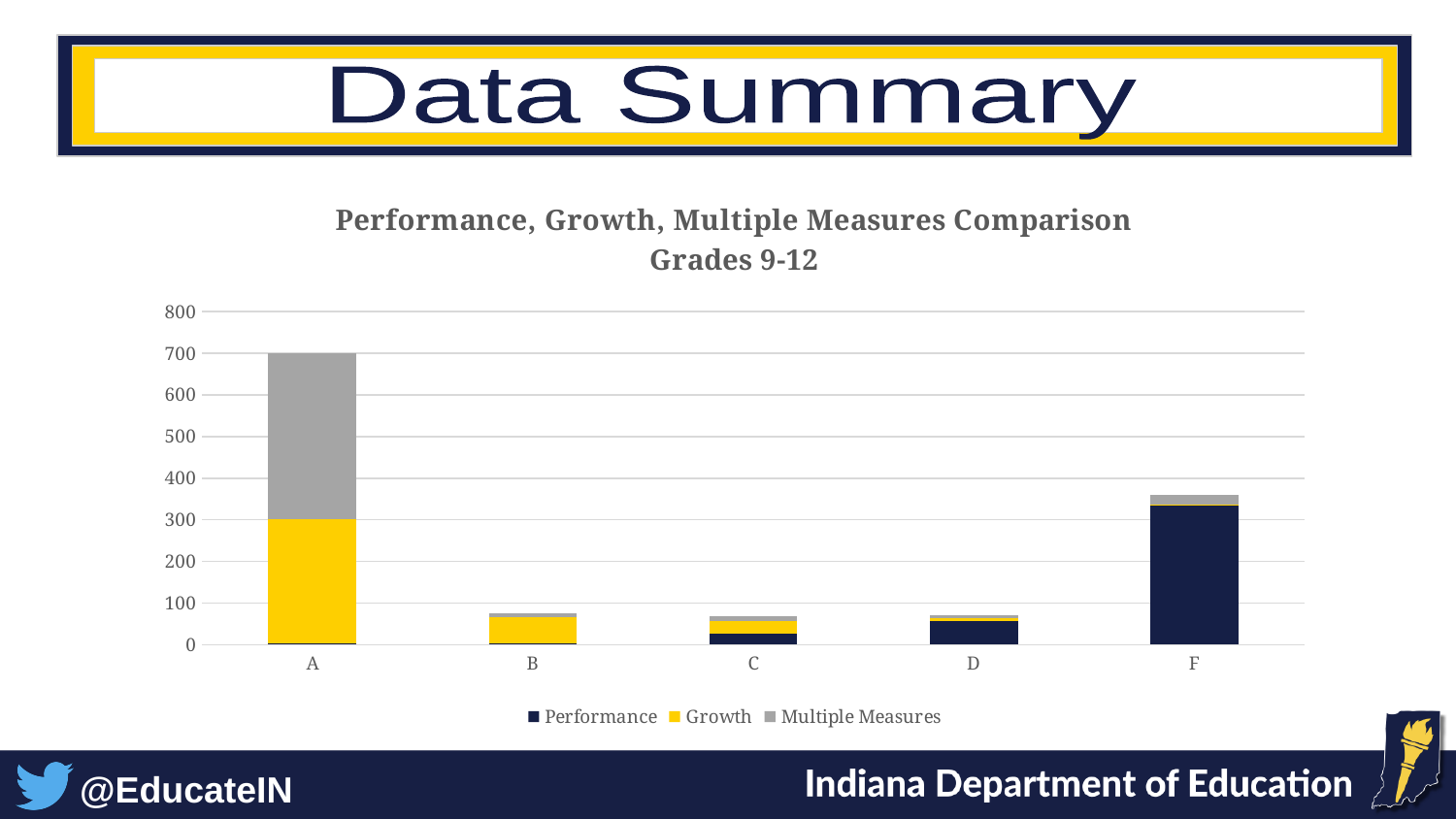
How many series does the chart's legend list? 3 Which has a larger total stacked value, A or F? A Is the total stacked value for B greater or less than 100? less What are the three series listed in the chart's legend? Performance, Growth, Multiple Measures Is the total stacked value for A greater or less than 600? greater Which category has the largest Multiple Measures segment? A Which category has the tallest stacked bar overall? A Is the total stacked value for F greater or less than 300? greater How many categories are shown on the x axis of the chart? 5 Which has a larger Growth segment, A or B? A Which category has the largest Performance segment? F What kind of chart is shown on the slide? bar chart